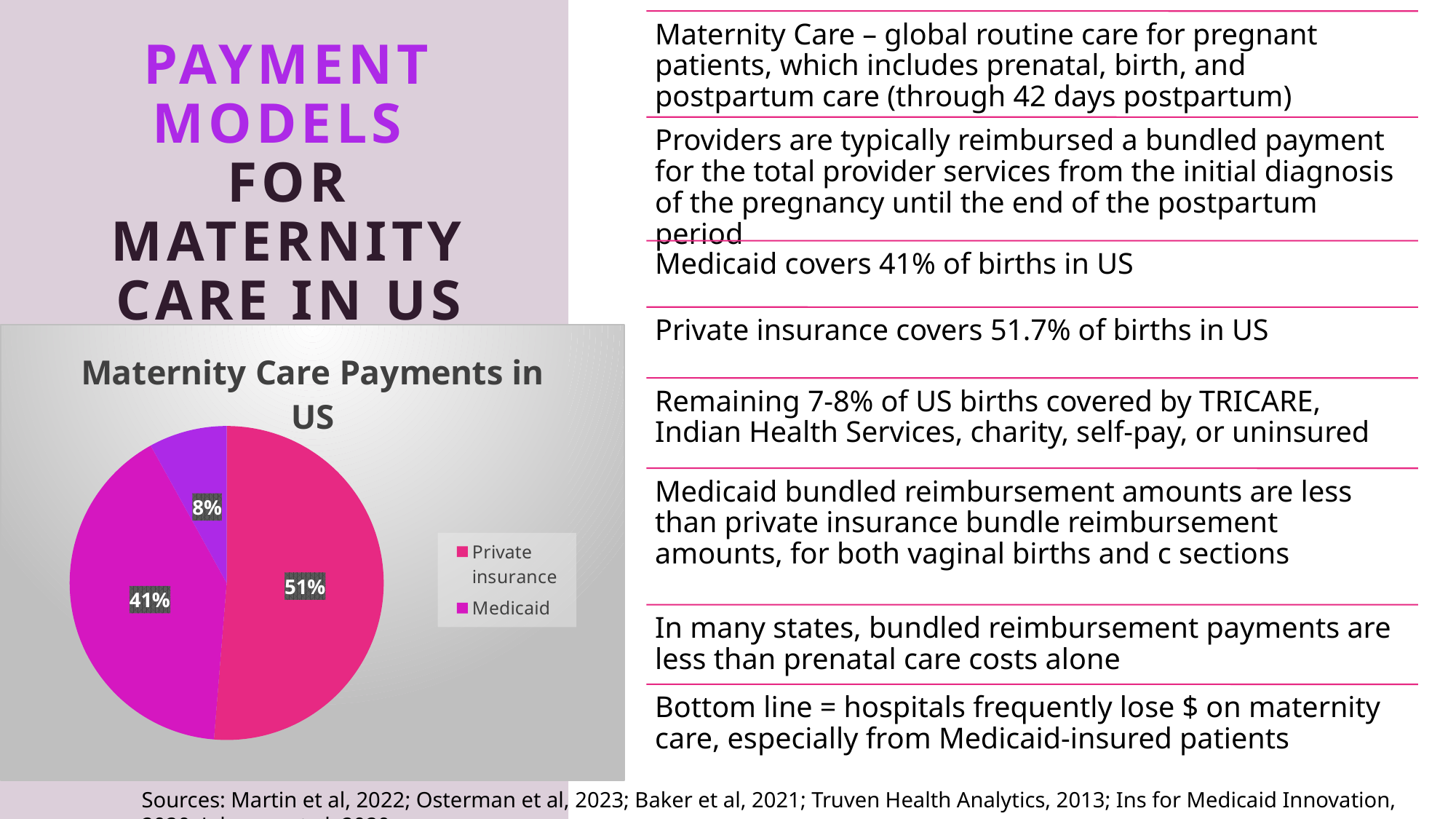
Is the Medicaid slice greater or less than 50% of the pie? less How many slices does the pie chart have? 3 What percentage of the pie is labelled for Medicaid? 41% What share of the pie does Medicaid represent? 41% What kind of chart is shown on the slide? pie chart Which is larger, the Private insurance slice or the Medicaid slice? Private insurance What is the value printed on the smallest slice of the pie? 8% Which category has the largest slice of the pie? Private insurance Which category is listed first in the chart's legend? Private insurance What percentage of the pie is labelled for Private insurance? 51% What is the title of the chart? Maternity Care Payments in US By how many percentage points does the Private insurance slice exceed the Medicaid slice? 10 percentage points